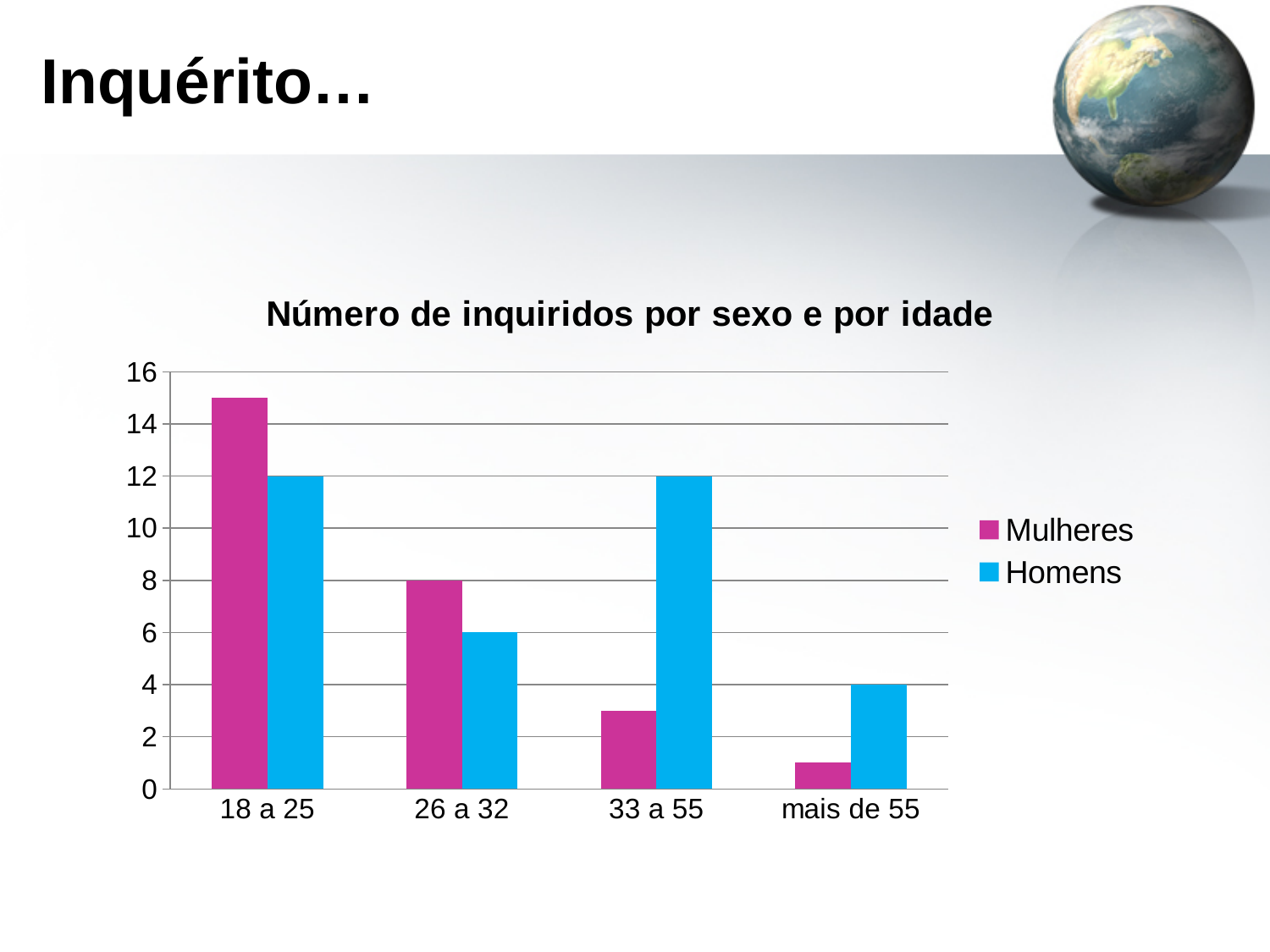
In the 26 a 32 age group, which series has the larger value, Mulheres or Homens? Mulheres What is the value for Mulheres in the 26 a 32 age group? 8 Is the value for Mulheres in the 18 a 25 age group greater or less than 14? greater Which age group has the highest value for Mulheres? 18 a 25 Which age group has the lowest value for Homens? mais de 55 How many age groups are shown on the x axis? 4 What is the value for Homens in the 18 a 25 age group? 12 Is the value for Mulheres in the 33 a 55 age group greater or less than 4? less What is the value for Homens in the mais de 55 age group? 4 What is the value for Homens in the 26 a 32 age group? 6 What is the difference between the Homens value for 18 a 25 and the Homens value for mais de 55? 8 Do the Mulheres values rise or fall from left to right across the age groups? fall